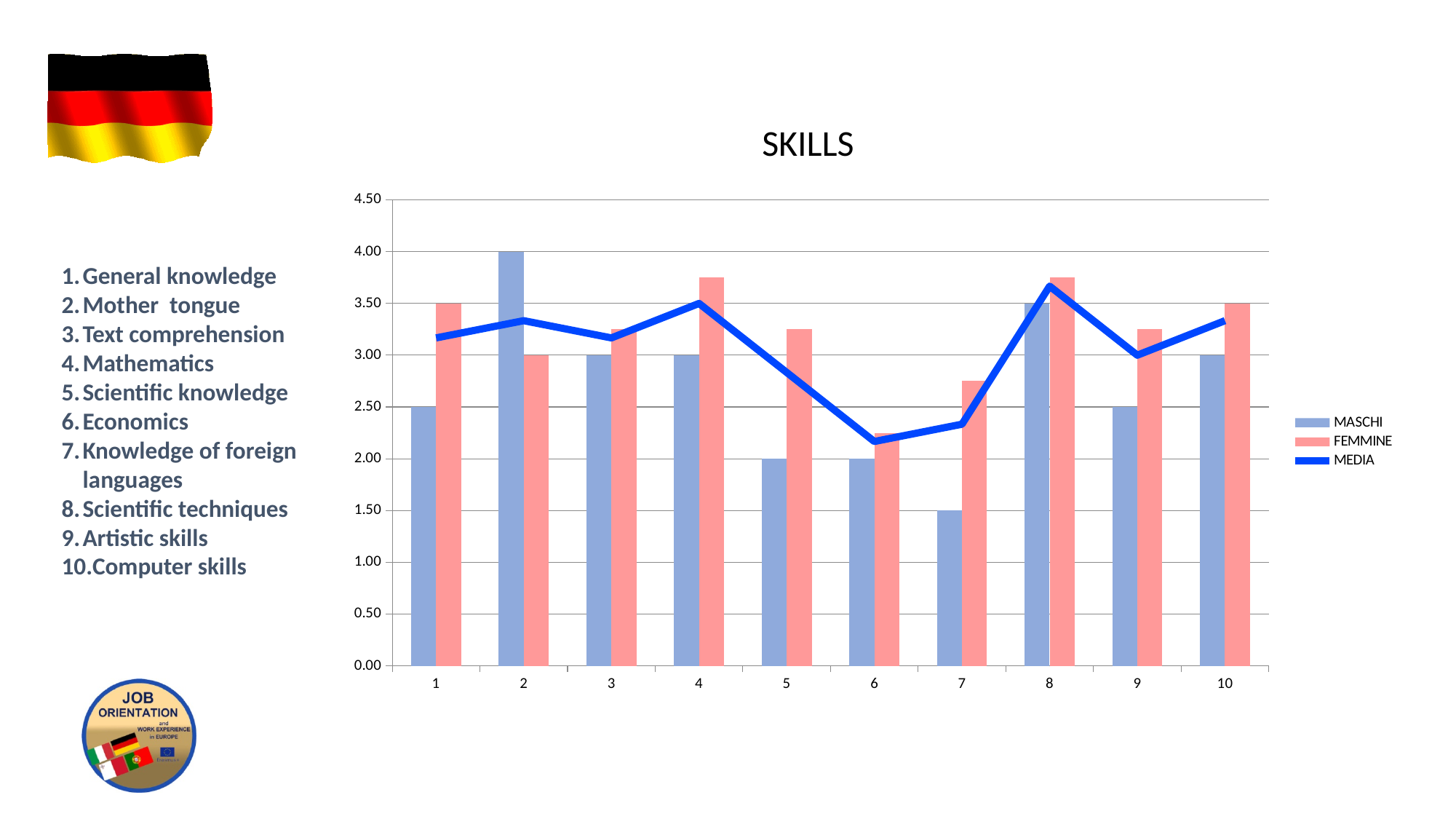
Which category has the lowest FEMMINE value? 6 What is the title of the chart? SKILLS Is the FEMMINE value for category 4 greater or less than 3.50? greater Which category has the lowest MASCHI value? 7 How many series does the legend list? 3 What kind of chart is shown on the slide? bar chart with a line What is the MASCHI value for category 7? 1.50 What is the MASCHI value for category 2? 4.00 Which category has the highest MASCHI value? 2 What is the difference between the MASCHI values for category 2 and category 7? 2.50 For category 1, which is larger, MASCHI or FEMMINE? FEMMINE How many categories are shown on the x axis? 10